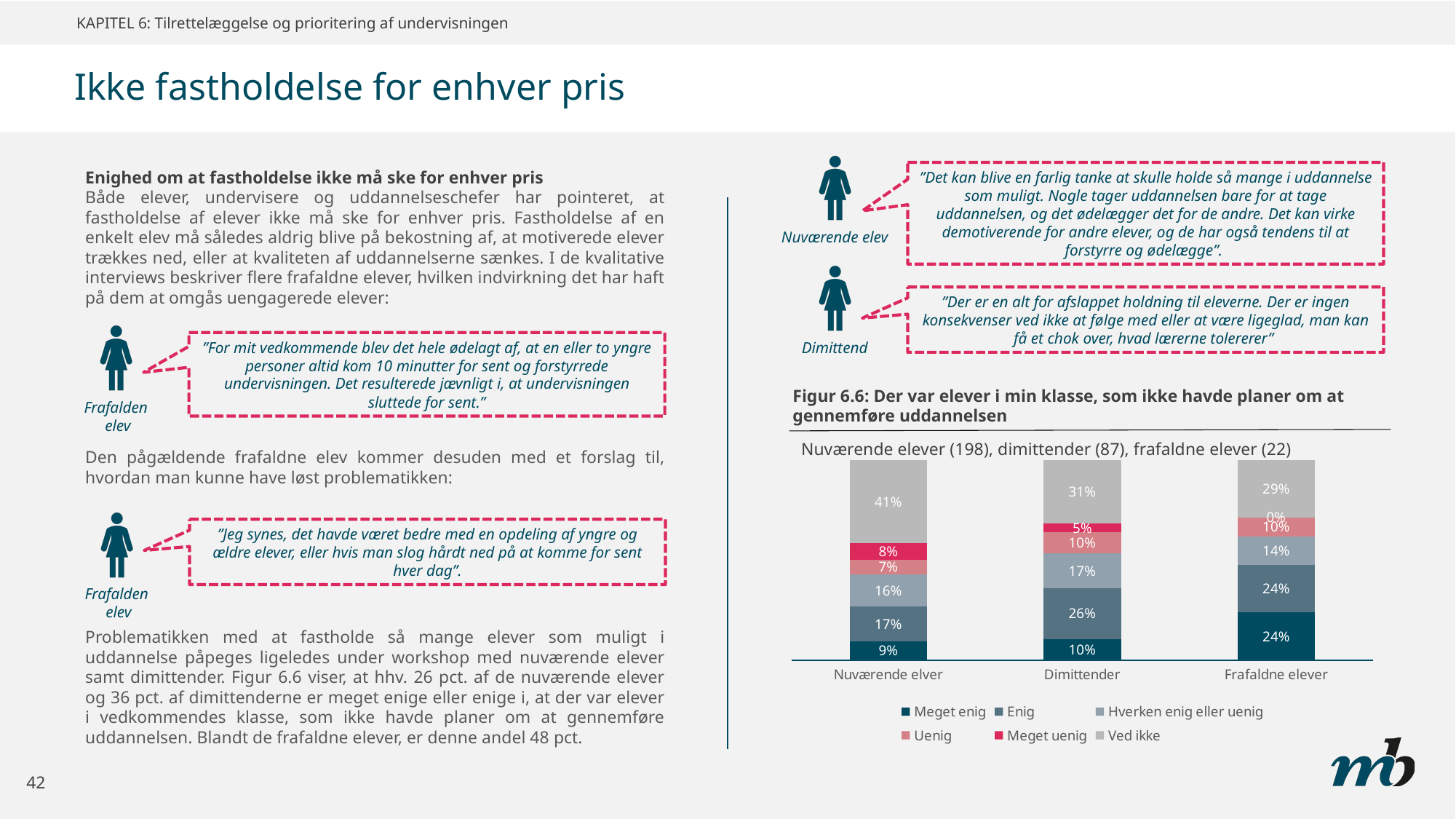
In Figur 6.6, which category has the lowest 'Ved ikke' value? Frafaldne elever In Figur 6.6, what is the 'Meget uenig' value for Frafaldne elever? 0% In Figur 6.6, is the 'Hverken enig eller uenig' value larger for Dimittender or for Frafaldne elever? Dimittender In Figur 6.6, what is the 'Ved ikke' value for Nuværende elver? 41% How many series does the legend of Figur 6.6 list? 6 In Figur 6.6, what is the difference between the 'Enig' values for Dimittender and Nuværende elver? 9% In Figur 6.6, what is the 'Enig' value for Dimittender? 26% What kind of chart is Figur 6.6? Stacked bar chart In Figur 6.6, what is the 'Meget enig' value for Frafaldne elever? 24% In Figur 6.6, which category has the highest 'Meget enig' value? Frafaldne elever How many categories are shown on the x axis of Figur 6.6? 3 In Figur 6.6, what is the combined 'Meget enig' and 'Enig' share for Dimittender? 36%